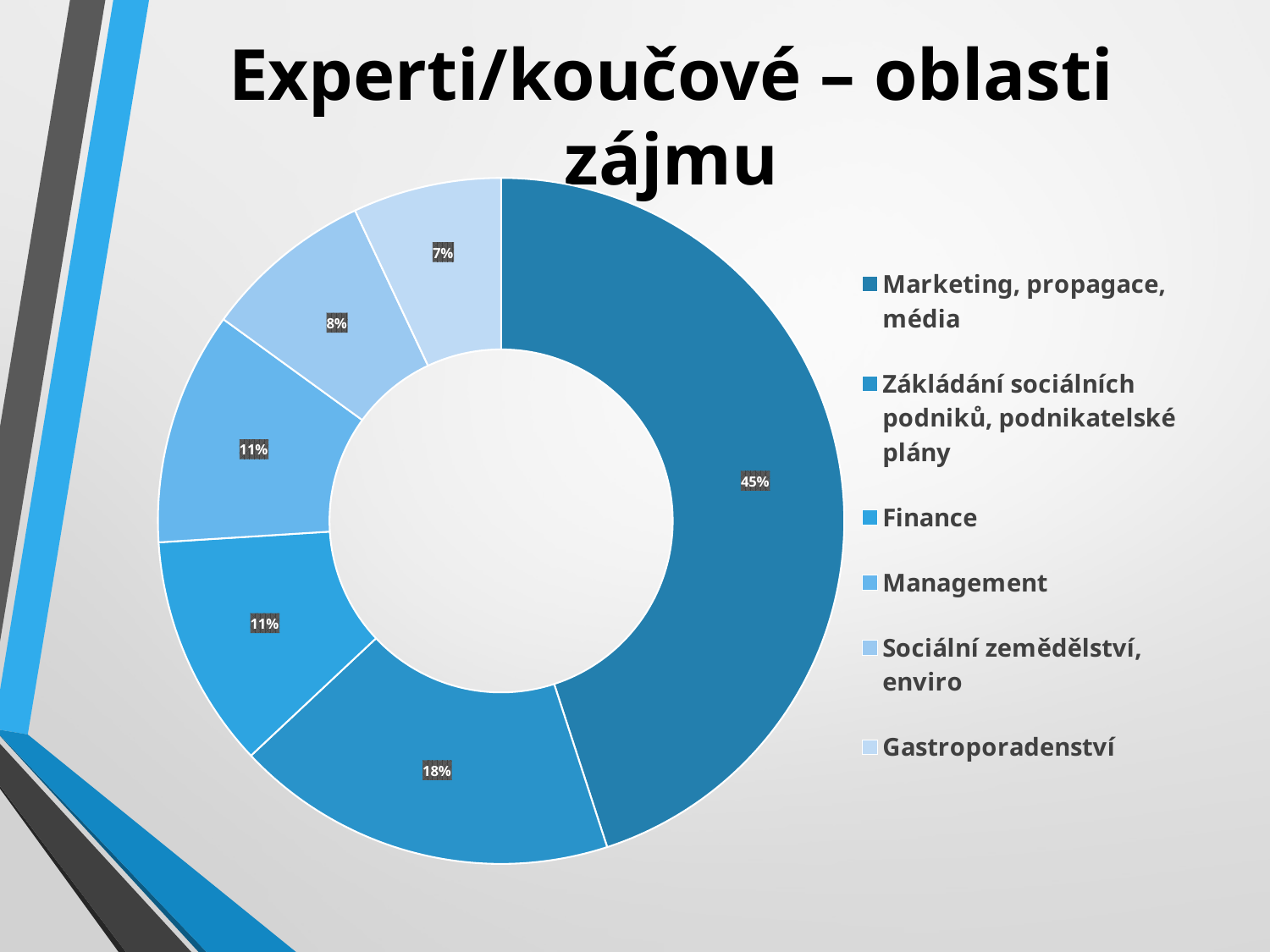
What is the difference in percentage points between Marketing, propagace, média and Zakládání sociálních podniků, podnikatelské plány? 27 percentage points Which category has the smallest share of the chart? Gastroporadenství Which is larger, the share for Finance or the share for Sociální zemědělství, enviro? Finance What is the title of the slide containing the chart? Experti/koučové – oblasti zájmu Which category has the largest share of the chart? Marketing, propagace, média What percentage is shown for Sociální zemědělství, enviro? 8% What share of the chart does Marketing, propagace, média have? 45% What kind of chart is shown on the slide? Doughnut chart What percentage is shown for Zakládání sociálních podniků, podnikatelské plány? 18% What percentage is shown for Gastroporadenství? 7% How many categories does the chart show? 6 What is the combined share of Finance and Management? 22%